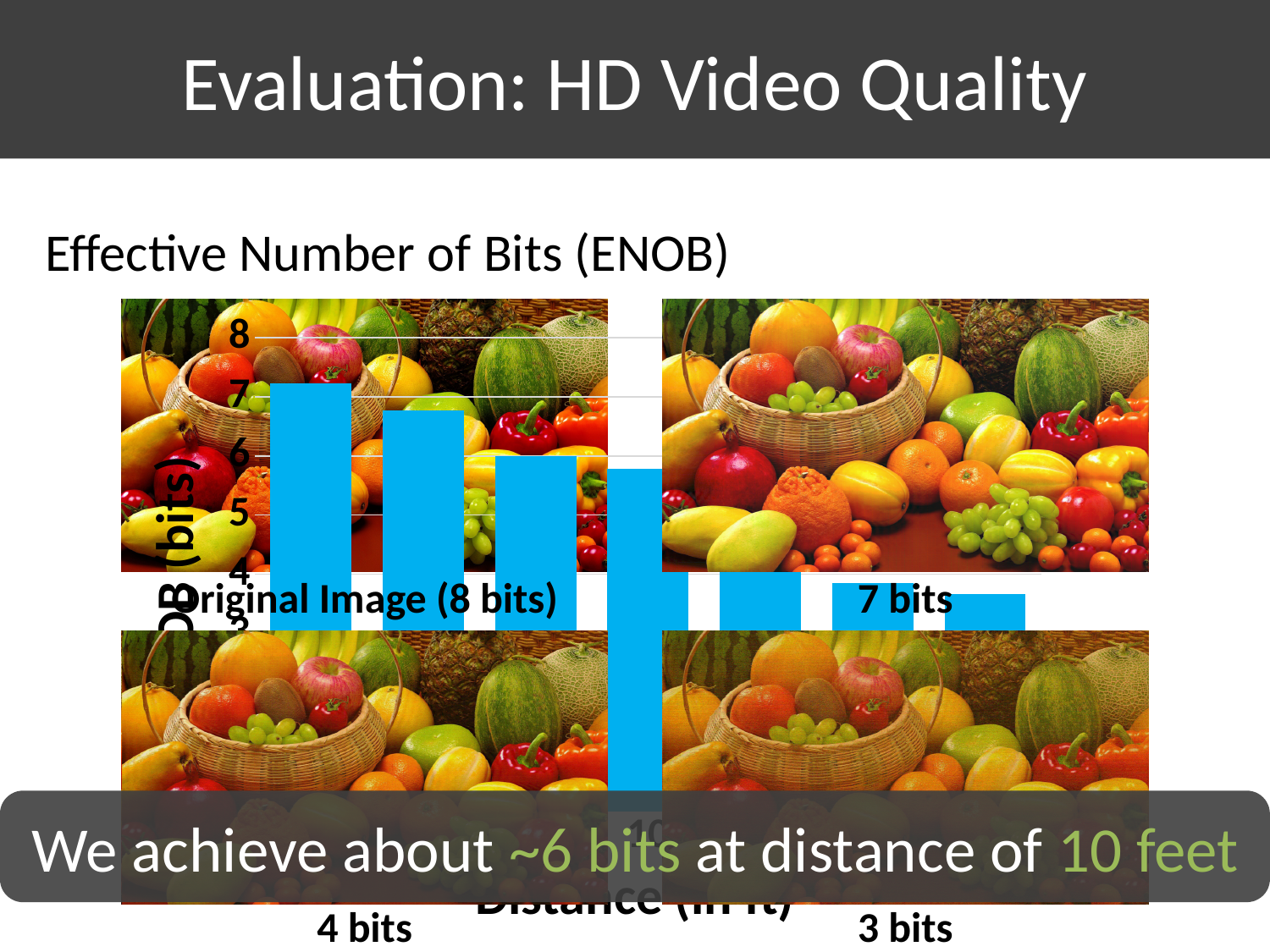
What is the title of the chart's y axis? ENOB (bits) Which bar is the highest, the leftmost or the rightmost? leftmost Is the value of the rightmost bar greater or less than 4? less What is the title of the chart's x axis? Distance (in ft) Is the value of the leftmost bar greater or less than 6? greater What kind of chart is shown on the slide? bar chart Do the bar values rise or fall as distance increases along the x axis? fall How many bars are plotted in the chart? 7